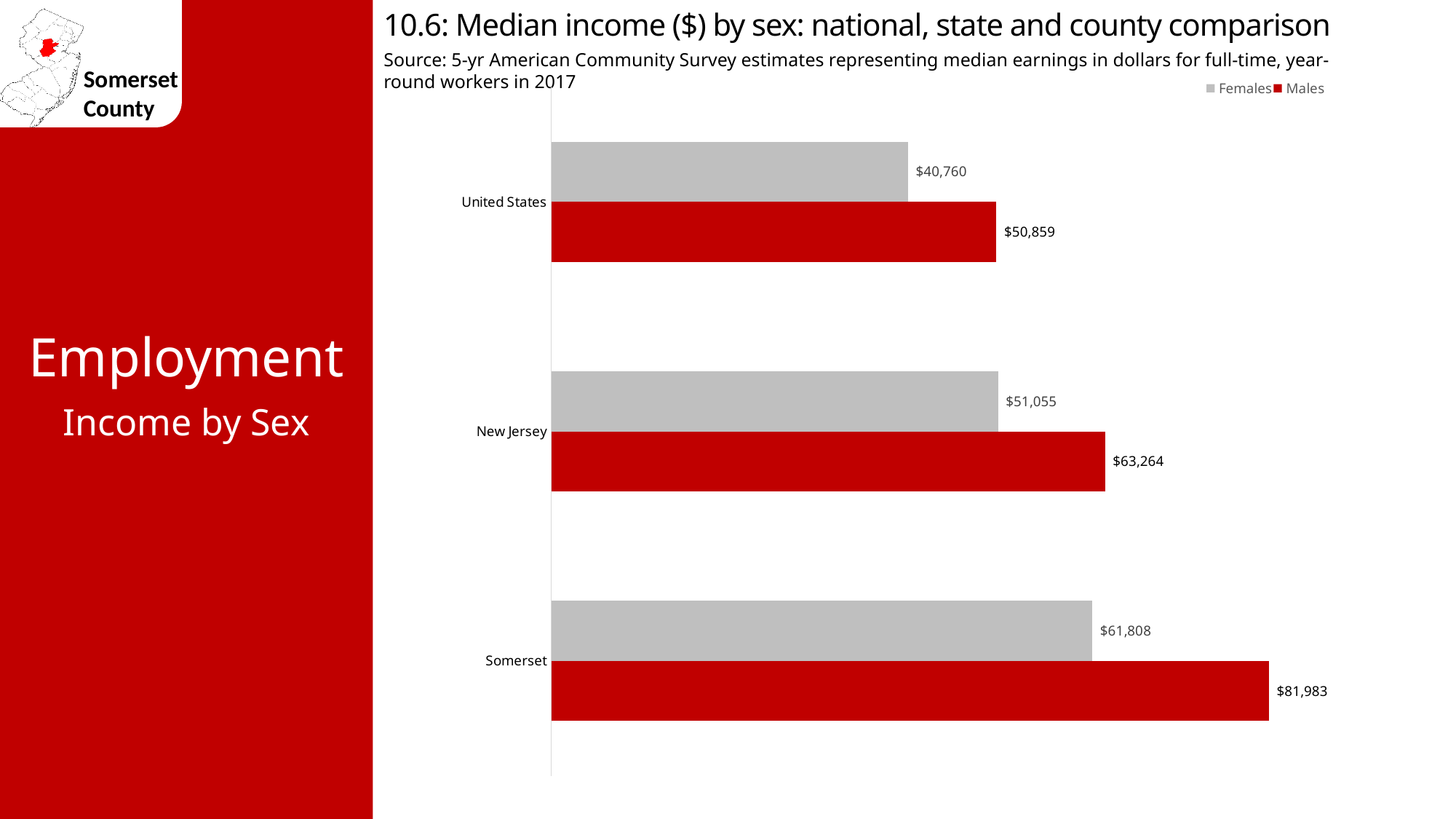
How many geographic categories are shown in the chart? 3 What kind of chart is shown on the slide? Bar chart Which is larger: the median income for females in New Jersey or for males in the United States? Females in New Jersey Which category has the highest median income for males? Somerset Which category has the lowest median income for females? United States What is the median income for females in Somerset? $61,808 What is the median income for males in Somerset? $81,983 How many series does the legend list? 2 What is the median income for females in the United States? $40,760 What is the difference between male and female median income in Somerset? $20,175 What is the difference between male and female median income in the United States? $10,099 What is the median income for males in New Jersey? $63,264